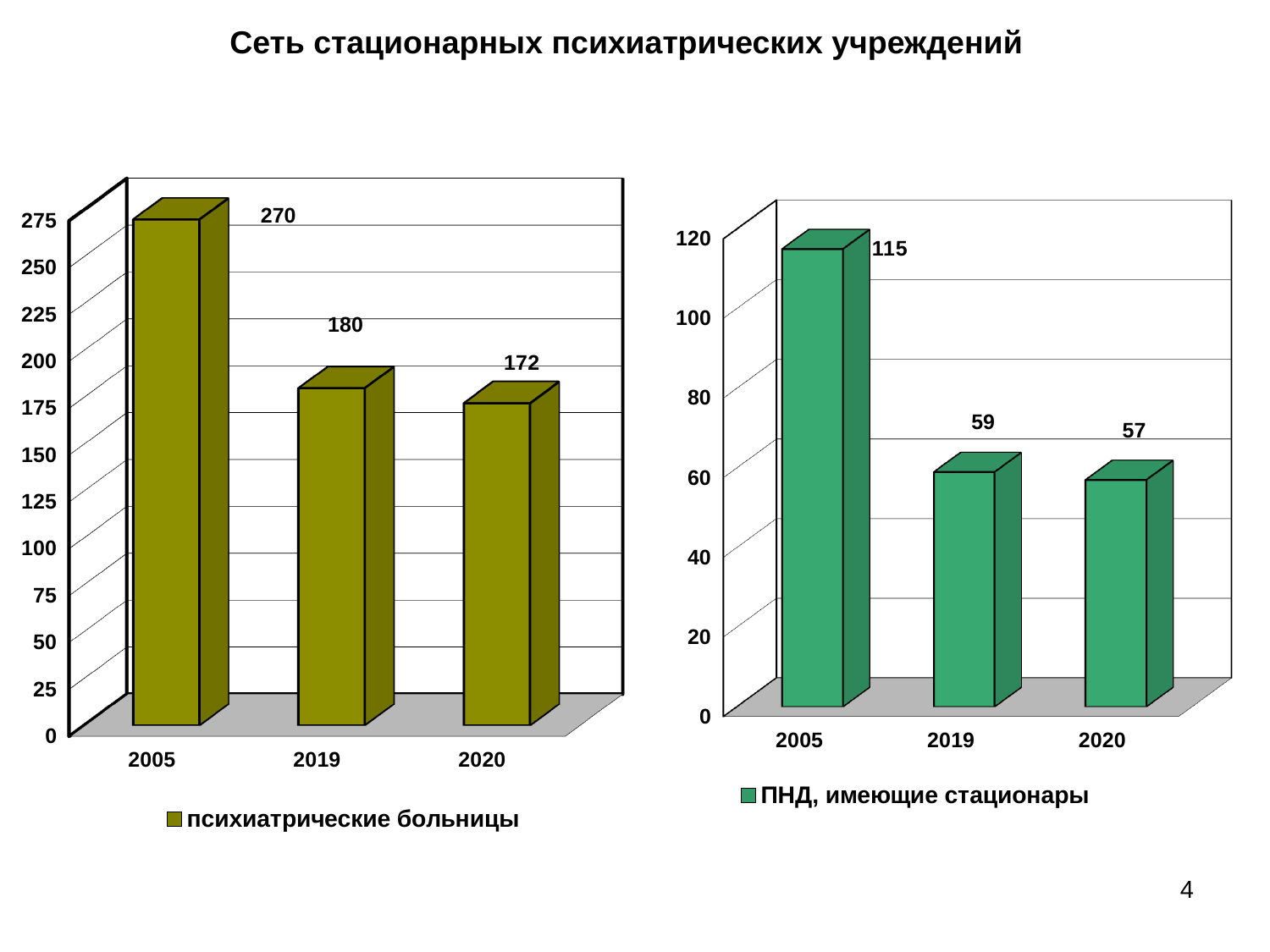
In the left chart (психиатрические больницы), what is the difference between the values for 2005 and 2019? 90 In the left chart (психиатрические больницы), what is the value for 2020? 172 In the left chart (психиатрические больницы), how many years are shown on the x axis? 3 In the right chart (ПНД, имеющие стационары), what is the difference between the values for 2005 and 2020? 58 What kind of chart is the right chart (ПНД, имеющие стационары)? bar chart In the left chart (психиатрические больницы), what is the value for 2005? 270 In the left chart (психиатрические больницы), which year has the lowest value? 2020 In the right chart (ПНД, имеющие стационары), what is the value for 2019? 59 What is the legend entry of the right chart? ПНД, имеющие стационары In the left chart (психиатрические больницы), do the values rise or fall from 2005 to 2020? fall In the right chart (ПНД, имеющие стационары), which year has the highest value? 2005 In the right chart (ПНД, имеющие стационары), which is larger, the value for 2019 or the value for 2020? 2019